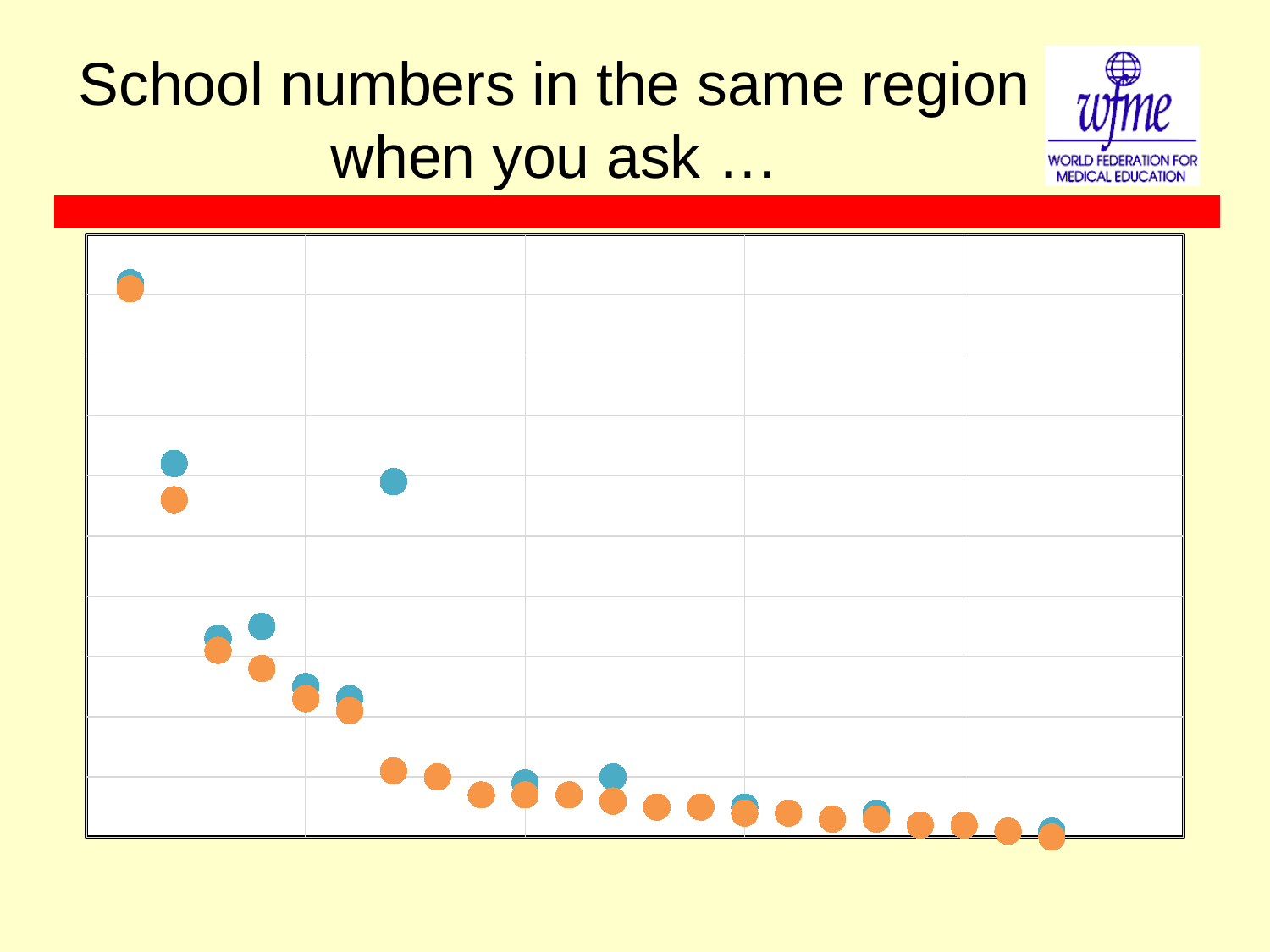
Which point is the highest on the chart: the leftmost point or the rightmost point? The leftmost point Is the leftmost point higher or lower than the second point from the left? Higher Do the plotted values generally rise or fall from left to right along the x axis? Fall What kind of chart is shown on the slide? Scatter chart What is the title of the slide containing the chart? School numbers in the same region when you ask … Where on the chart is the lowest point located: at the left end or the right end? The right end What two colours are used for the plotted points? Blue and orange